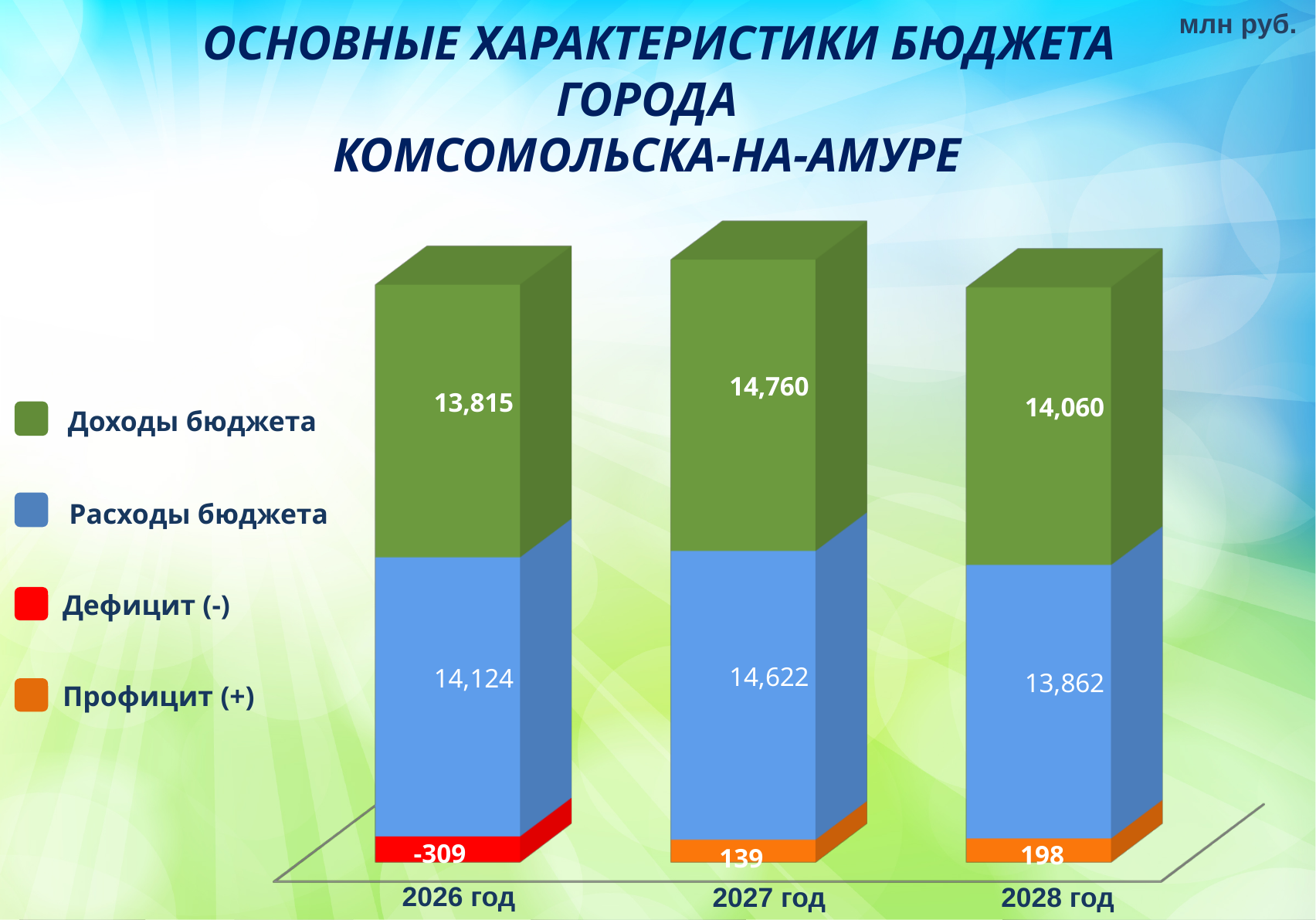
What is the value of Доходы бюджета for 2026 год? 13,815 Which year has the highest value of Доходы бюджета? 2027 год What is the value of Расходы бюджета for 2027 год? 14,622 What is the value of Профицит (+) for 2028 год? 198 How many entries does the legend list? 4 What is the difference between Расходы бюджета in 2027 год and 2028 год? 760 Which year has the lowest value of Расходы бюджета? 2028 год Which is larger in 2026 год: Доходы бюджета or Расходы бюджета? Расходы бюджета What is the difference between Доходы бюджета in 2027 год and 2026 год? 945 What is the value of Дефицит (-) for 2026 год? -309 How many years are shown on the x axis of the chart? 3 What kind of chart is shown on the slide? Stacked bar chart